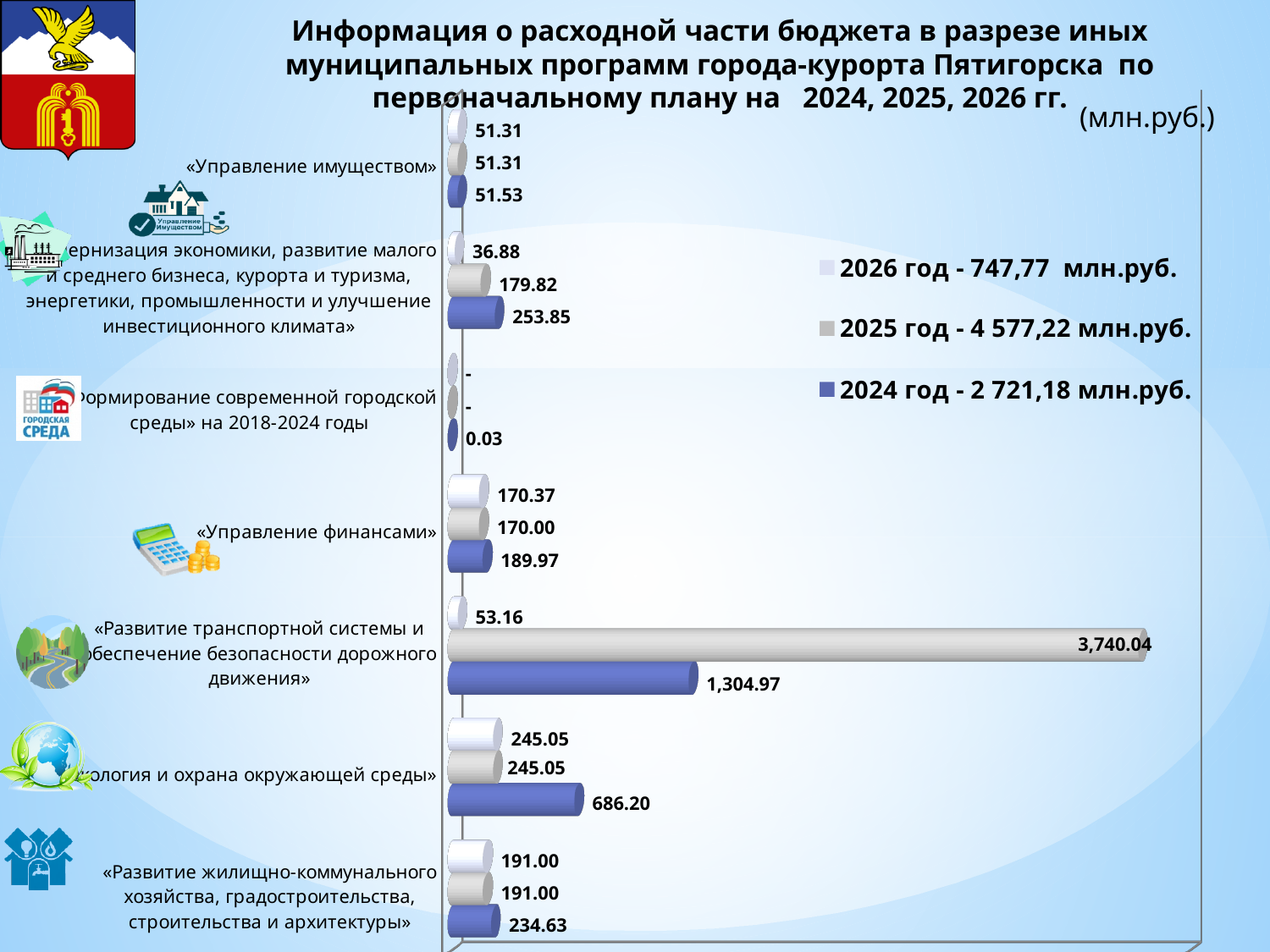
How many series does the legend list? 3 Which is larger for «Модернизация экономики...»: the 2025 value or the 2024 value? 2024 value (253.85) What is the 2024 value for «Развитие транспортной системы и обеспечение безопасности дорожного движения»? 1,304.97 What type of chart is shown on the slide? bar chart How many categories (municipal programmes) are plotted on the chart? 7 What is the 2026 value for «Управление финансами»? 170.37 Which category has the lowest 2024 value? «Формирование современной городской среды» на 2018-2024 годы What is the difference between the 2024 and 2026 values for «Экология и охрана окружающей среды»? 441.15 What is the difference between the 2025 and 2024 values for «Развитие транспортной системы и обеспечение безопасности дорожного движения»? 2,435.07 Which category has the highest 2025 value? «Развитие транспортной системы и обеспечение безопасности дорожного движения» According to the legend, what is the total for 2025 год? 4 577,22 млн.руб. What is the 2025 value for «Экология и охрана окружающей среды»? 245.05